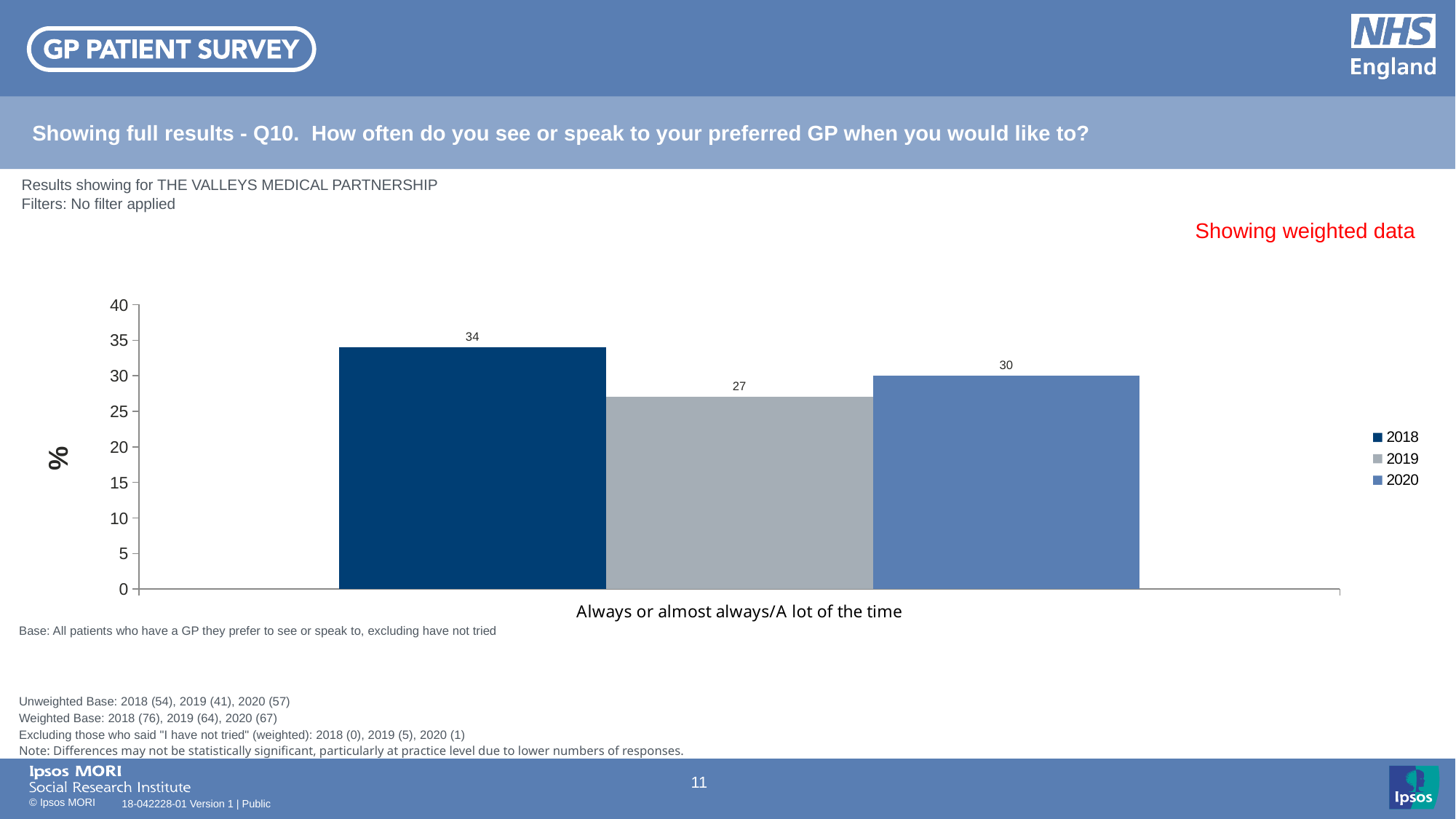
What is the difference between the 2020 and 2019 values? 3 Is the value for 2019 greater or less than 30? less Which is larger, the value for 2018 or the value for 2020? 2018 How many series does the legend list? 3 Which year has the lowest value? 2019 What is the value for 2019 for 'Always or almost always/A lot of the time'? 27 What is the value for 2018 for 'Always or almost always/A lot of the time'? 34 What kind of chart is shown on the slide? bar chart What is the difference between the 2018 and 2019 values? 7 What is the label on the y axis of the chart? % Which year has the highest value? 2018 What is the value for 2020 for 'Always or almost always/A lot of the time'? 30